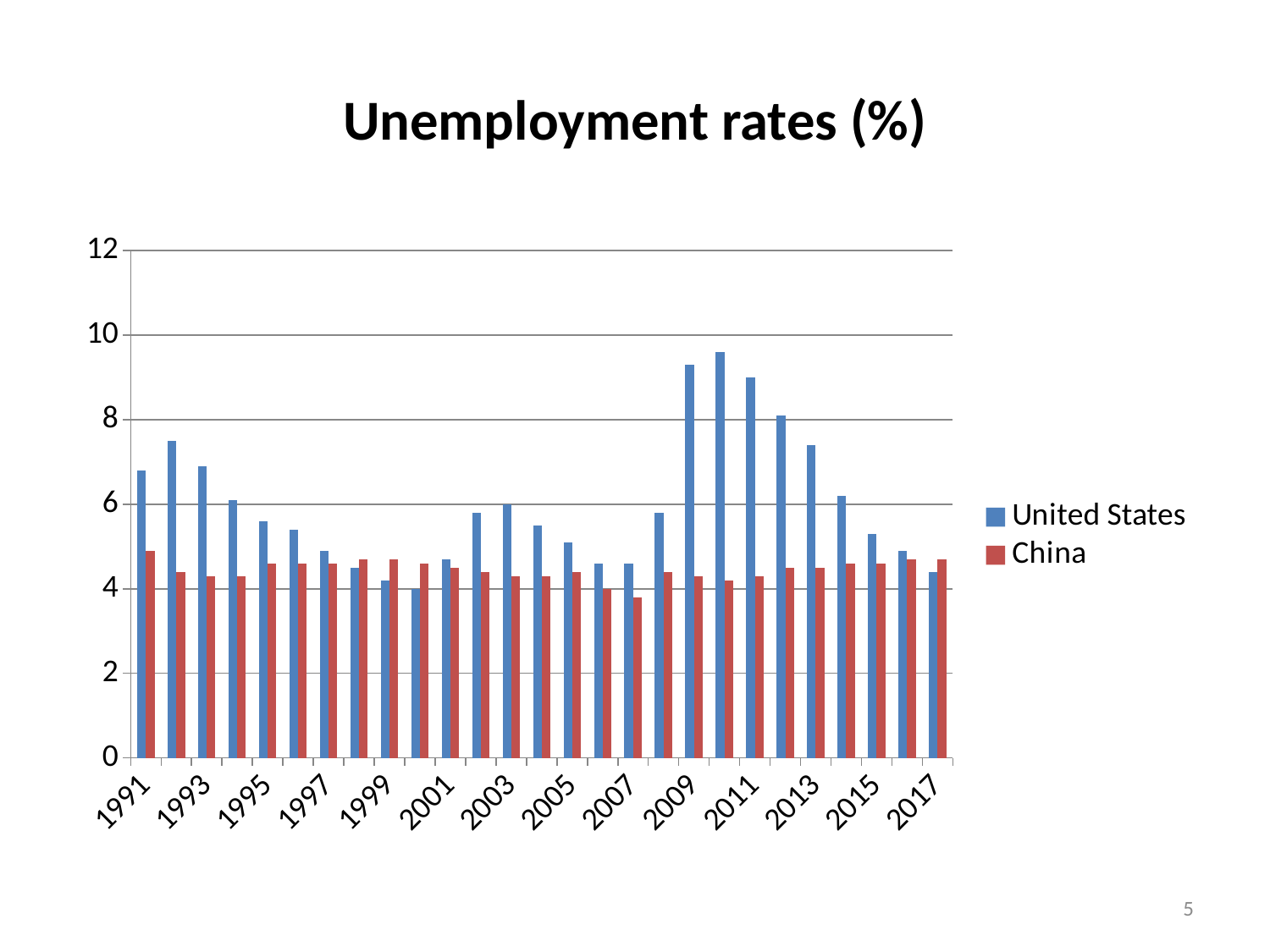
Is the United States value for 2000 greater or less than 6? less Is the China value for 1991 greater or less than 6? less Do the United States values rise or fall from 2010 to 2017? fall Is the United States value for 2010 greater or less than 8? greater What is the title of the chart? Unemployment rates (%) Which colour represents China in the chart? red In which year is the United States unemployment rate highest? 2010 What type of chart is shown on the slide? bar chart How many series does the legend list? 2 In 2000, which is larger, the United States value or the China value? China In 2010, which is larger, the United States value or the China value? United States